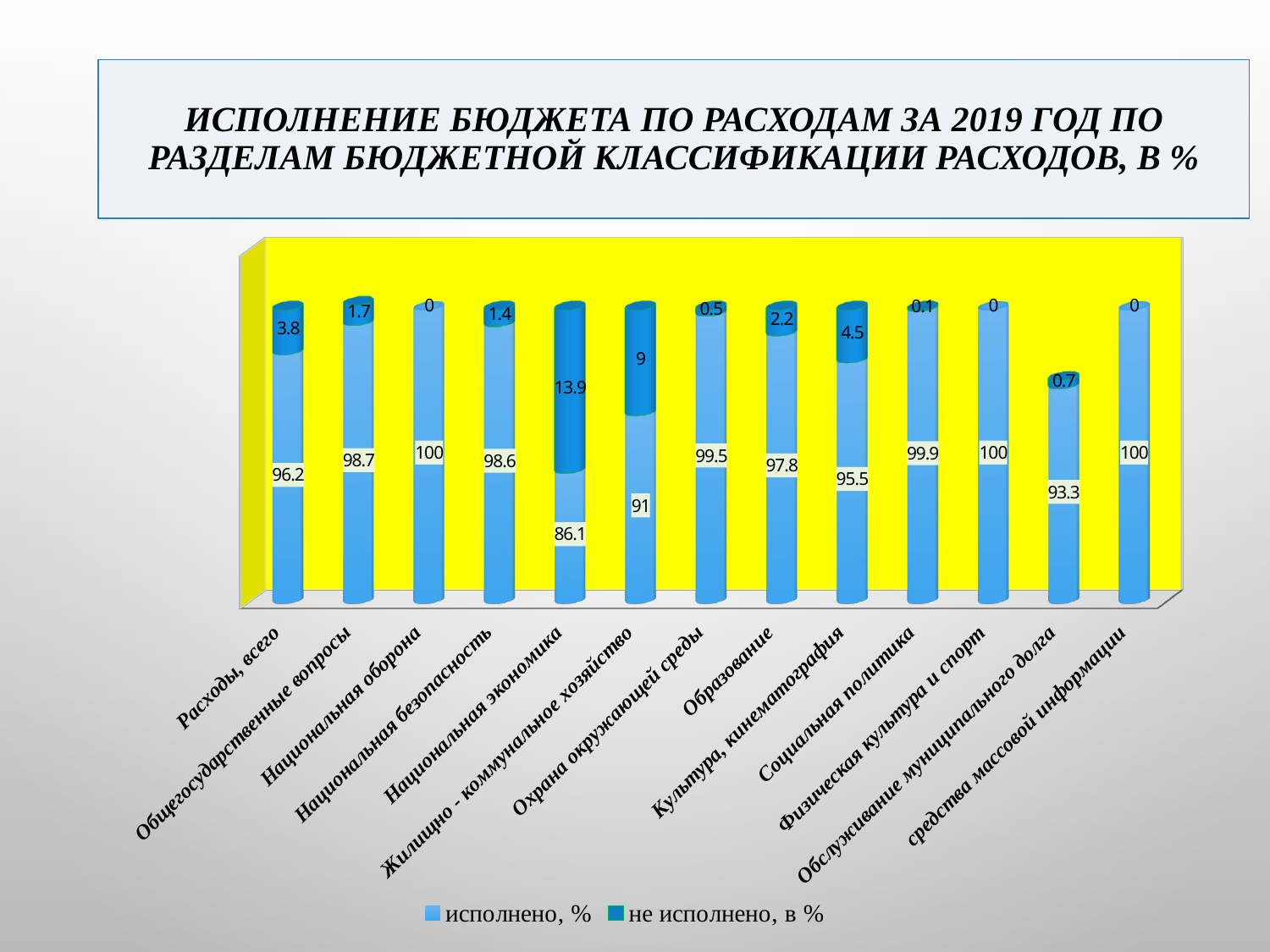
Which category has the highest value of "не исполнено, в %"? Национальная экономика What is the total of the stacked bar for Национальная экономика? 100 How many series does the legend list? 2 What is the value of "исполнено, %" for Расходы, всего? 96.2 What is the value of "исполнено, %" for Национальная экономика? 86.1 What kind of chart is shown on the slide? Stacked bar chart Which category has the lowest value of "исполнено, %"? Национальная экономика What is the difference between the "исполнено, %" values for Общегосударственные вопросы and Образование? 0.9 How many categories are shown on the x axis of the chart? 13 What is the value of "не исполнено, в %" for Жилищно - коммунальное хозяйство? 9 What is the value of "не исполнено, в %" for Культура, кинематография? 4.5 Which is larger, the "исполнено, %" value for Социальная политика or for Обслуживание муниципального долга? Социальная политика